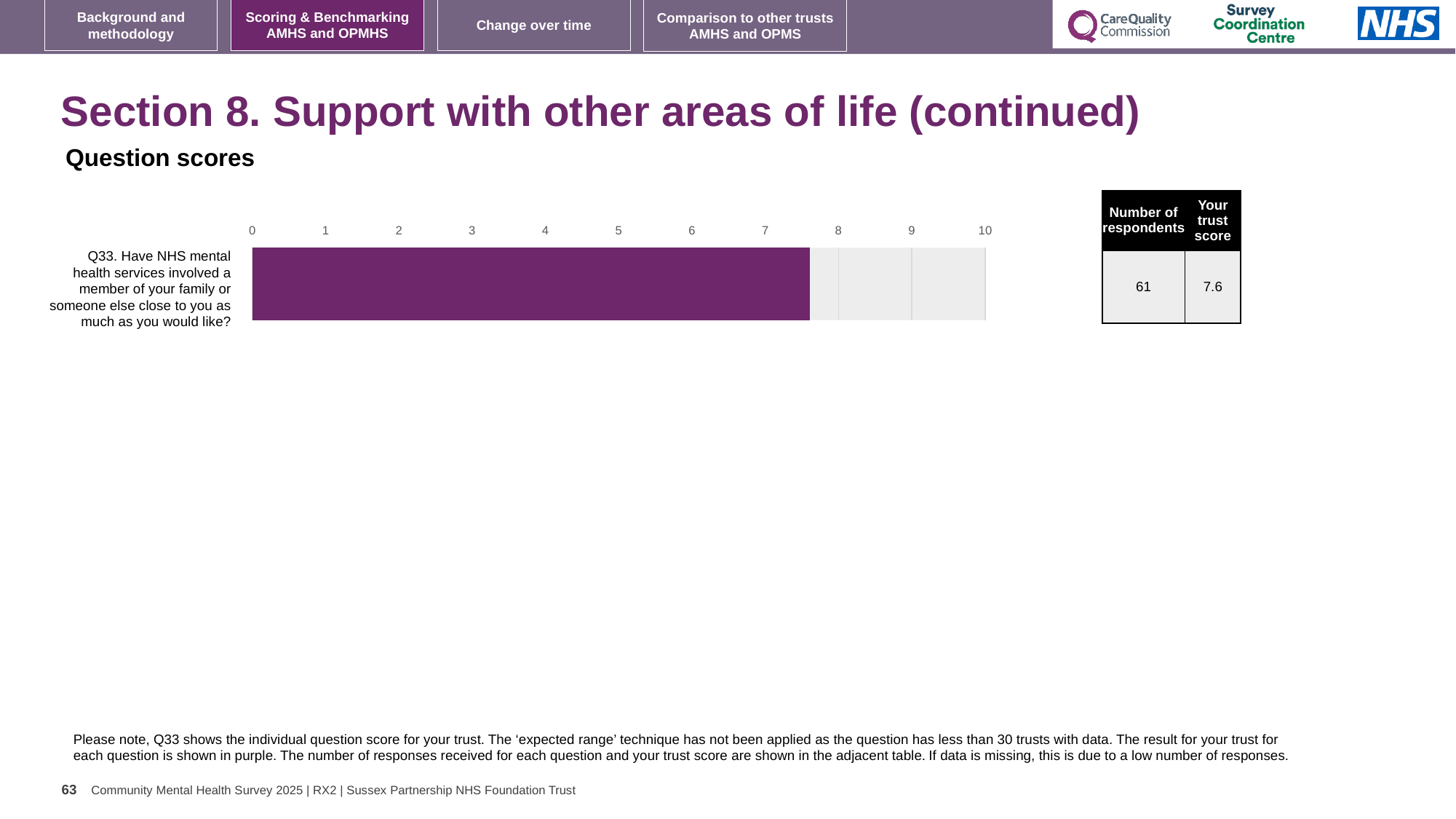
What colour is the bar showing the trust's result for Q33? purple Is the bar for Q33 greater or less than 5 on the axis? greater What is the trust score for Q33 shown in the adjacent table? 7.6 How many respondents answered Q33 according to the table? 61 What kind of chart is shown on the slide? bar chart Is the bar for Q33 greater or less than 7 on the axis? greater Is the bar for Q33 greater or less than 8 on the axis? less How many questions (bars) are plotted in the chart? 1 What is the maximum value shown on the chart's axis? 10